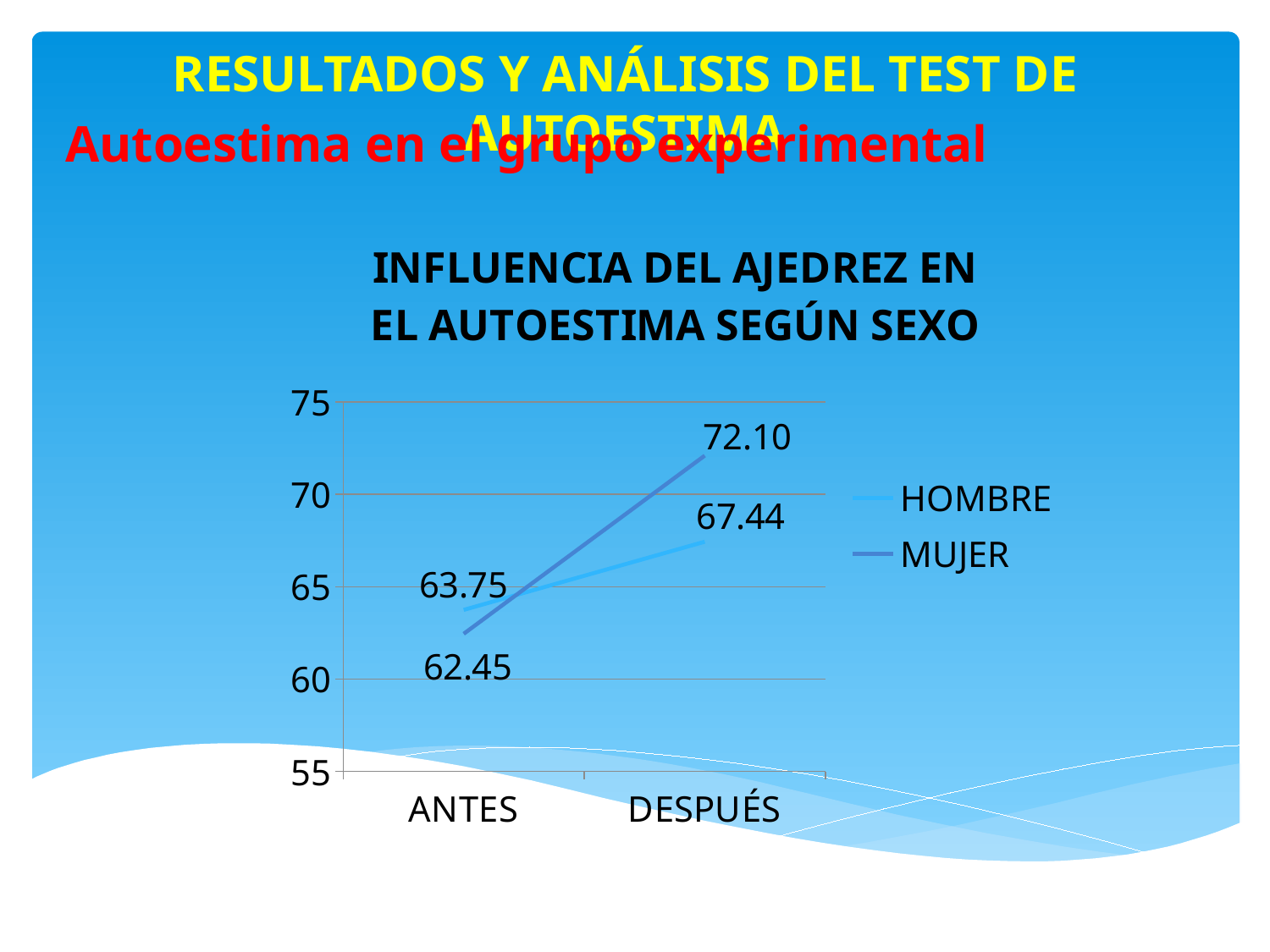
What is the difference between the MUJER values at DESPUÉS and ANTES? 9.65 What type of chart is shown on the slide? Line chart What is the title of the chart? INFLUENCIA DEL AJEDREZ EN EL AUTOESTIMA SEGÚN SEXO How many categories are shown on the x axis? 2 How many series does the legend list? 2 What is the value for HOMBRE at DESPUÉS? 67.44 Which series has the higher value at DESPUÉS, HOMBRE or MUJER? MUJER What is the value for MUJER at DESPUÉS? 72.10 What is the value for MUJER at ANTES? 62.45 What is the value for HOMBRE at ANTES? 63.75 What is the difference between the HOMBRE values at DESPUÉS and ANTES? 3.69 Do the values for MUJER rise or fall from ANTES to DESPUÉS? Rise